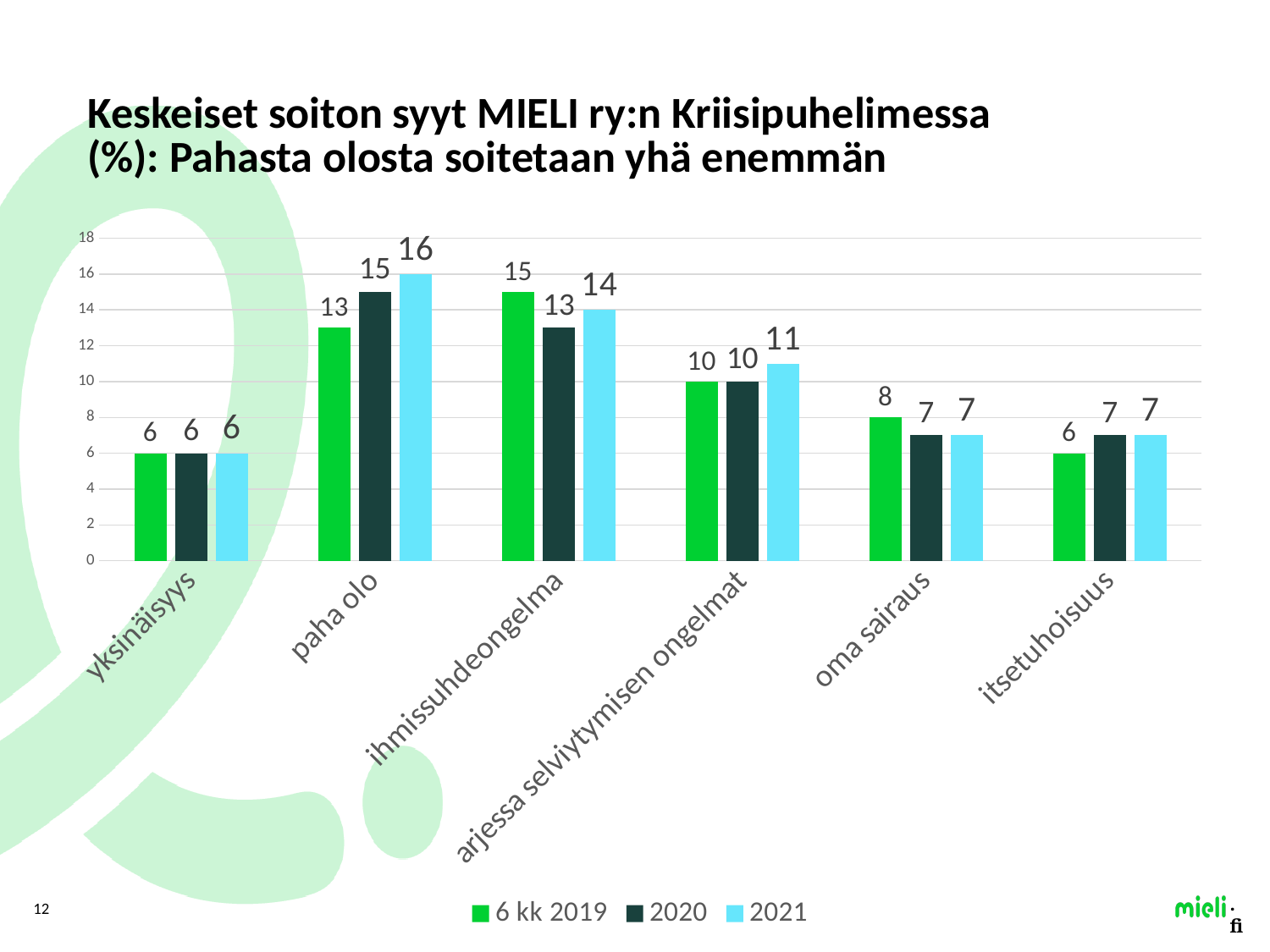
What is the difference between the 2021 and '6 kk 2019' values for 'paha olo'? 3 What is the value for 'paha olo' in the 2021 series? 16 Do the values for 'paha olo' rise or fall from '6 kk 2019' to 2021? rise What is the value for 'oma sairaus' in the 2020 series? 7 What kind of chart is shown on the slide? bar chart How many categories are shown on the x axis? 6 Which category has the lowest value in the 2020 series? yksinäisyys Which is larger for 'ihmissuhdeongelma': the '6 kk 2019' value or the 2020 value? 6 kk 2019 How many series does the legend list? 3 Which series is shown in light blue in the legend? 2021 What is the value for 'ihmissuhdeongelma' in the '6 kk 2019' series? 15 Which category has the highest value in the 2021 series? paha olo